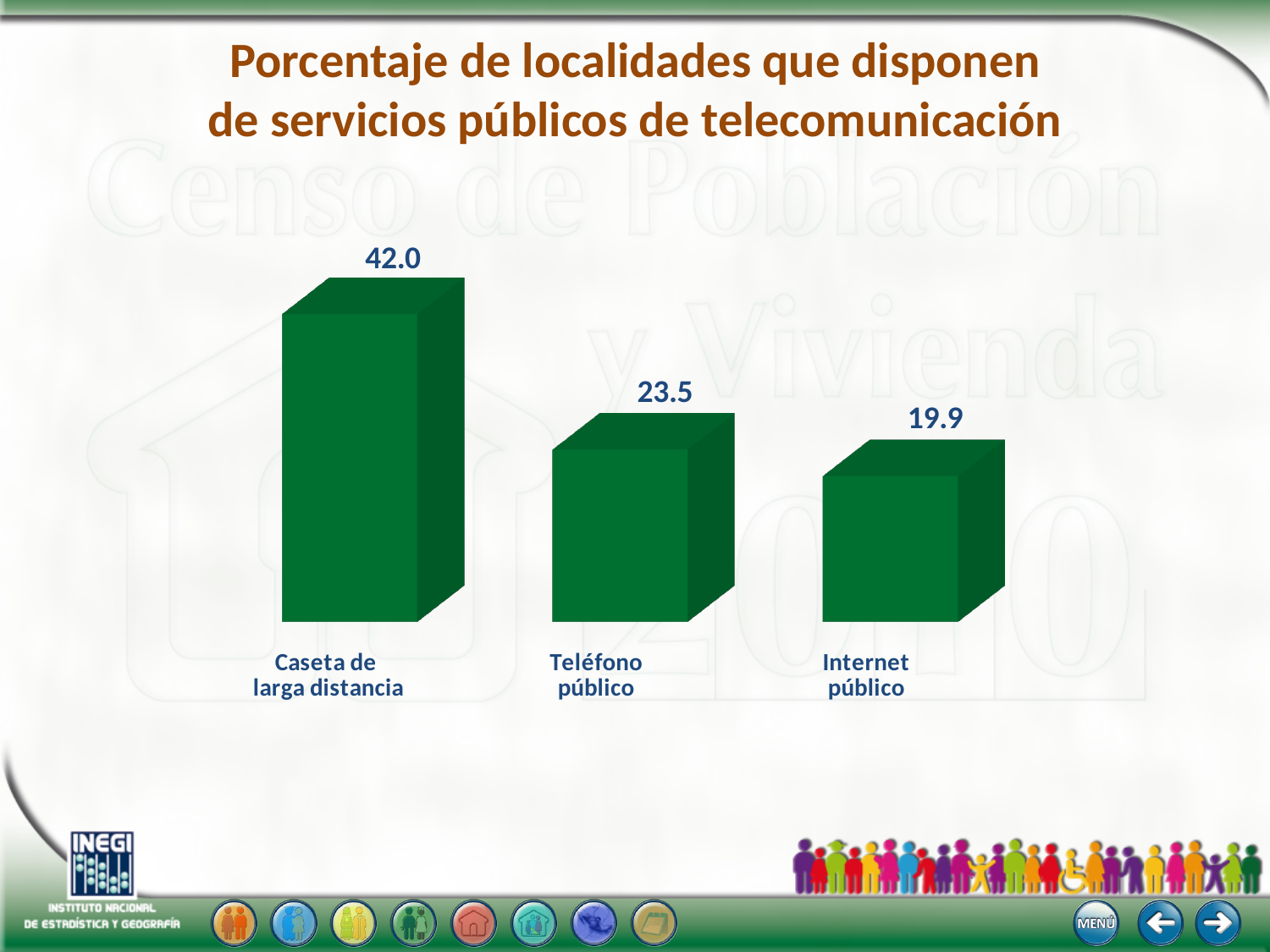
Which is larger, the value for Teléfono público or the value for Internet público? Teléfono público Which category has the lowest value? Internet público What is the value for Caseta de larga distancia? 42.0 How many categories are shown in the chart? 3 What kind of chart is shown on the slide? Bar chart What is the value for Internet público? 19.9 Do the values rise or fall from left to right across the categories? Fall Which category has the highest value? Caseta de larga distancia What is the value for Teléfono público? 23.5 What is the title of the chart? Porcentaje de localidades que disponen de servicios públicos de telecomunicación What is the difference between the values for Teléfono público and Internet público? 3.6 What is the difference between the values for Caseta de larga distancia and Teléfono público? 18.5